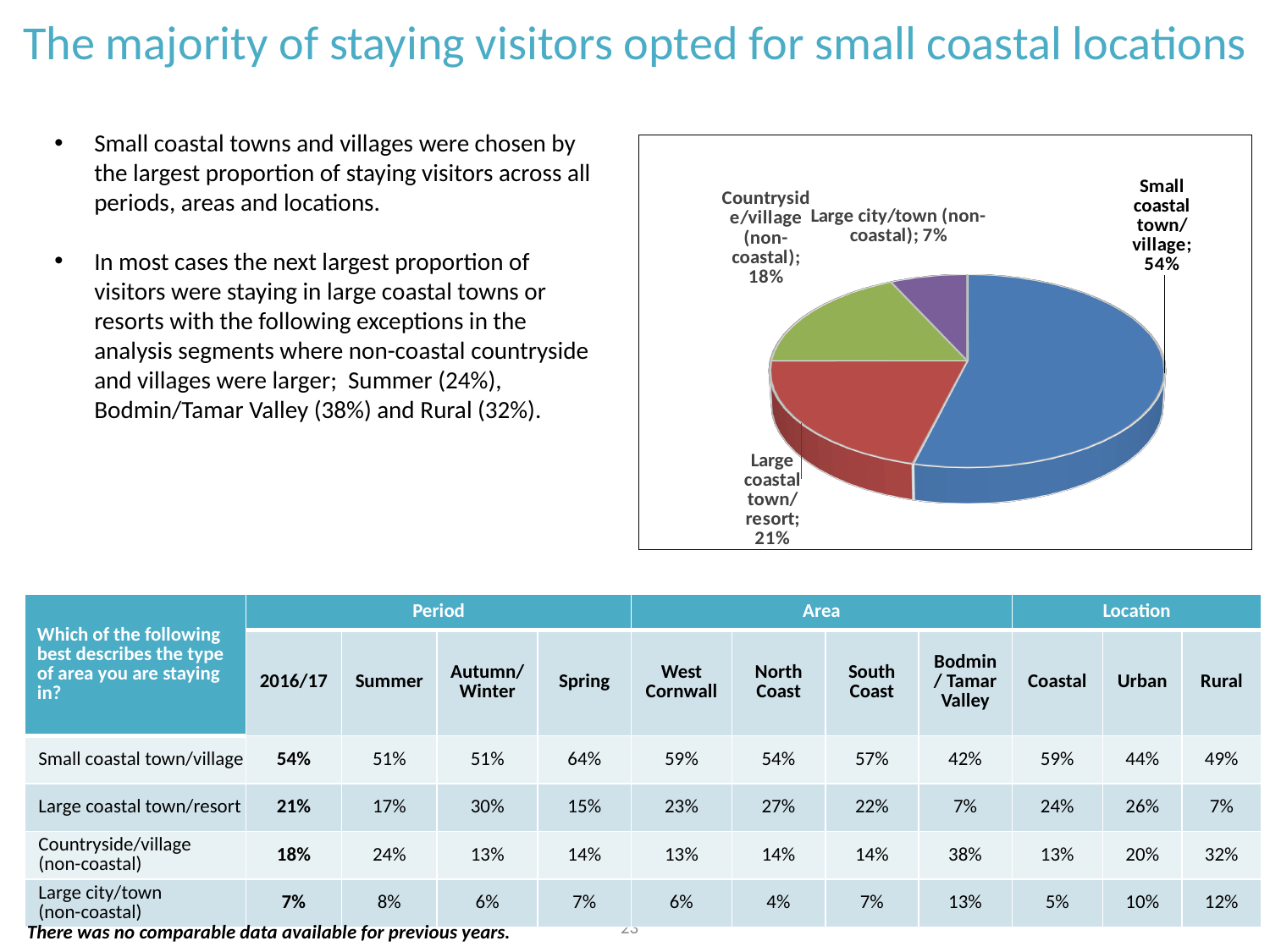
How many slices does the pie chart have? 4 What colour is the Small coastal town/village slice in the pie chart? Blue What share of the pie chart is Large coastal town/resort? 21% What share of the pie chart is Small coastal town/village? 54% What is the combined share of the two non-coastal slices in the pie chart? 25% What share of the pie chart is Countryside/village (non-coastal)? 18% What type of chart is shown on the slide? Pie chart What share of the pie chart is Large city/town (non-coastal)? 7% Which category has the largest slice in the pie chart? Small coastal town/village Which slice is larger in the pie chart: Large coastal town/resort or Countryside/village (non-coastal)? Large coastal town/resort Which category has the smallest slice in the pie chart? Large city/town (non-coastal) What is the difference in percentage points between the Small coastal town/village slice and the Large coastal town/resort slice? 33